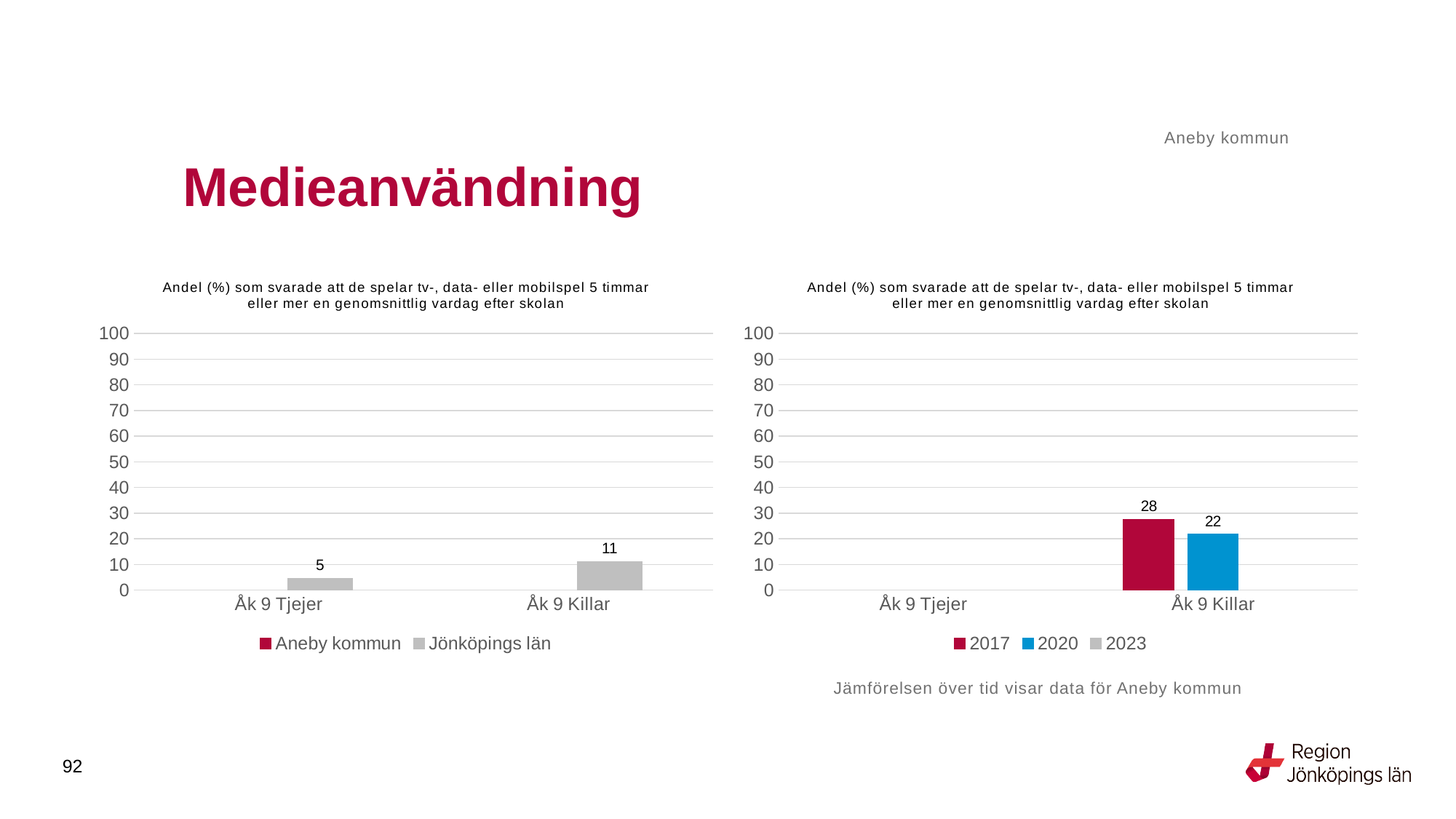
What kind of chart is the right chart? Bar chart In the right chart, what is the value for 2017 for Åk 9 Killar? 28 In the right chart, which year has the higher value for Åk 9 Killar, 2017 or 2020? 2017 In the left chart, what is the value for Jönköpings län for Åk 9 Killar? 11 In the right chart, what is the value for 2020 for Åk 9 Killar? 22 In the left chart, what is the value for Jönköpings län for Åk 9 Tjejer? 5 How many series does the legend of the left chart list? 2 In the left chart, what is the difference between the Jönköpings län values for Åk 9 Killar and Åk 9 Tjejer? 6 In the right chart, what is the difference between the 2017 and 2020 values for Åk 9 Killar? 6 How many series does the legend of the right chart list? 3 In the left chart, which category has the higher Jönköpings län value, Åk 9 Tjejer or Åk 9 Killar? Åk 9 Killar In the right chart, is the value for 2017 for Åk 9 Killar greater or less than 30? less